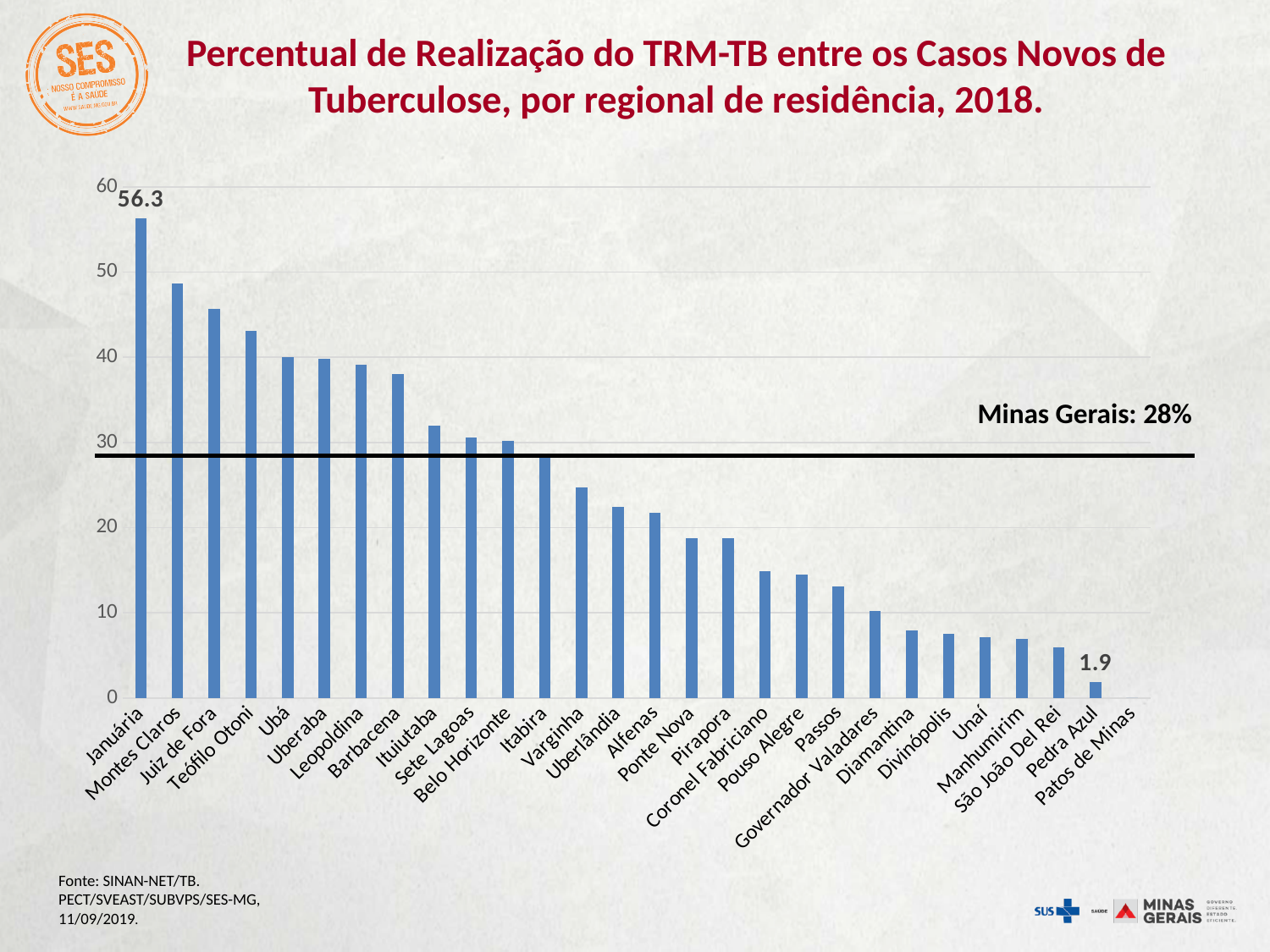
What is the difference between the values for Januária and Patos de Minas? 56.3 Which regional has the highest value? Januária What is the value for Januária? 56.3 Is the value for Juiz de Fora greater or less than 40? greater Which has a larger value, Montes Claros or Varginha? Montes Claros What value does the horizontal reference line labelled Minas Gerais represent? 28% Which regional has the lowest value? Patos de Minas Is the value for Diamantina greater or less than 10? less Is the value for Ponte Nova greater or less than 20? less What kind of chart is shown on the slide? bar chart What is the value for Patos de Minas? 0 How many regionals are shown on the chart? 28